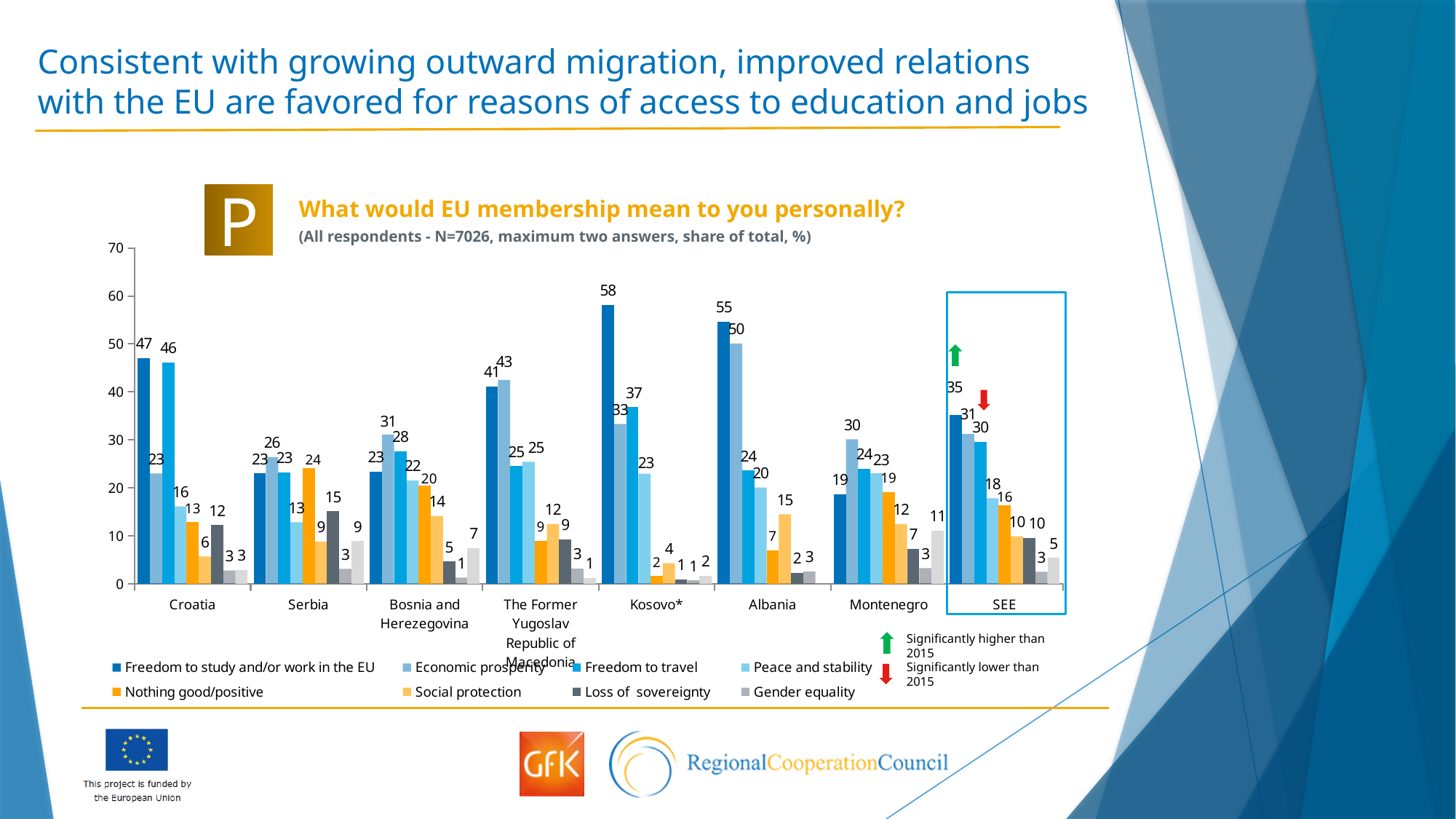
What is the value for Freedom to study and/or work in the EU for SEE? 35 In Bosnia and Herzegovina, which is larger: Economic prosperity or Freedom to travel? Economic prosperity What is the difference between the Freedom to study and/or work in the EU values for Kosovo* and Albania? 3 Which country has the lowest value for Freedom to study and/or work in the EU? Montenegro What kind of chart is shown on the slide? Bar chart How many countries/regions are shown on the x axis? 8 Which country has the highest value for Freedom to study and/or work in the EU? Kosovo* Is the value for Freedom to study and/or work in the EU in Kosovo* greater or less than 50? greater What question does the chart title ask? What would EU membership mean to you personally? What is the value for Freedom to study and/or work in the EU in Kosovo*? 58 What is the value for Freedom to travel in Croatia? 46 What is the value for Economic prosperity in Albania? 50